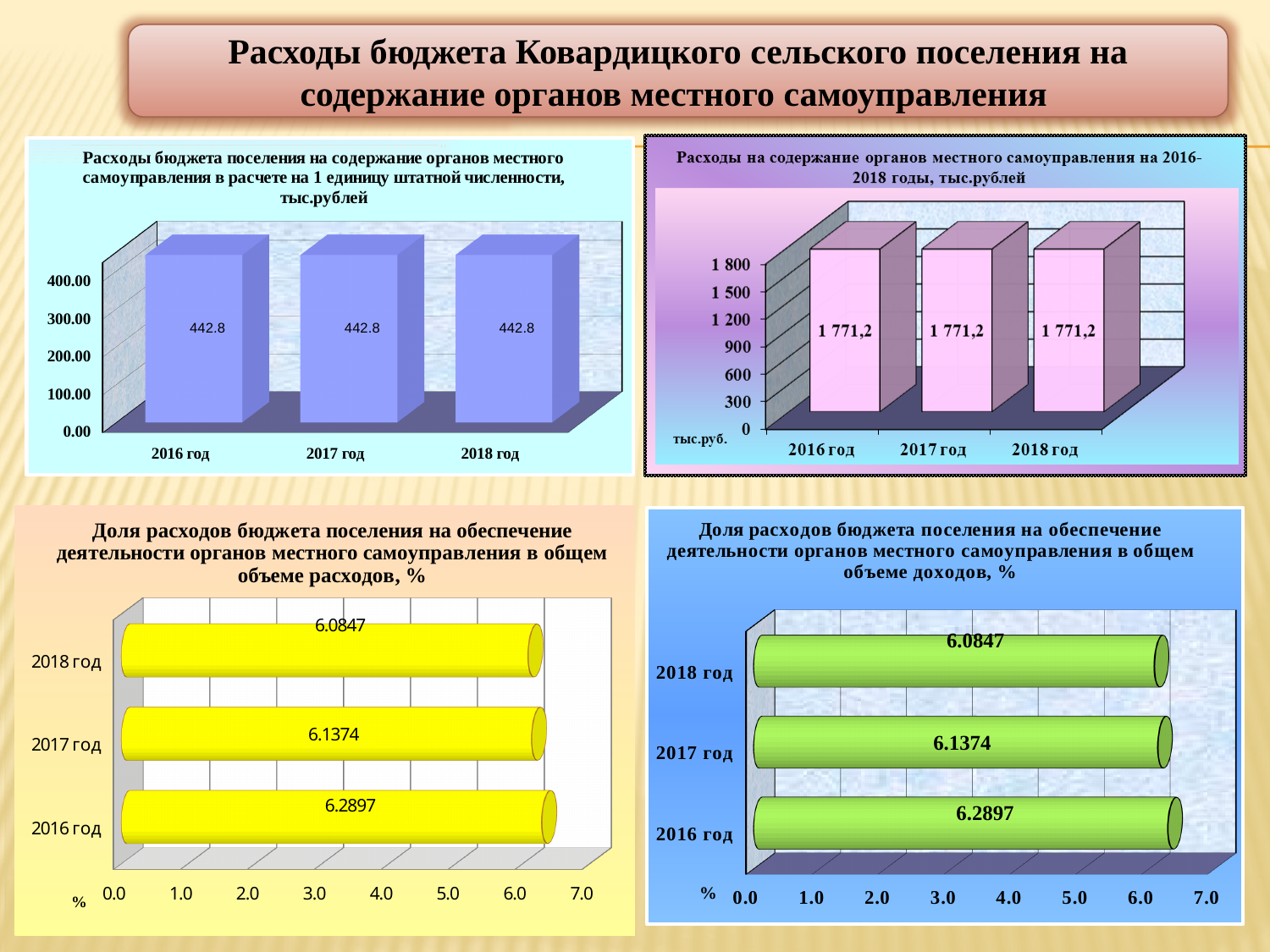
In the top-left chart (expenses per 1 unit of staff), what is the value for 2017 год? 442.8 In the bottom-left chart (share of expenses in total expenses, %), what is the value for 2016 год? 6.2897 In the top-left chart (expenses per 1 unit of staff), how many years are shown on the x axis? 3 In the top-right chart (expenses on local self-government bodies 2016-2018), what is the value for 2018 год? 1 771,2 In the bottom-right chart (share of expenses in total revenues, %), which is larger, the value for 2016 год or 2017 год? 2016 год In the top-right chart (expenses on local self-government bodies 2016-2018), what kind of chart is it? bar chart In the bottom-left chart (share of expenses in total expenses, %), which year has the lowest value? 2018 год In the bottom-right chart (share of expenses in total revenues, %), what colour are the bars? green In the top-left chart (expenses per 1 unit of staff), is the value for 2016 год greater or less than 400.00? greater In the bottom-left chart (share of expenses in total expenses, %), what is the difference between the 2016 год and 2018 год values? 0.2050 In the top-right chart (expenses on local self-government bodies 2016-2018), do the values rise, fall or stay the same from 2016 to 2018? stay the same In the bottom-right chart (share of expenses in total revenues, %), what is the value for 2017 год? 6.1374